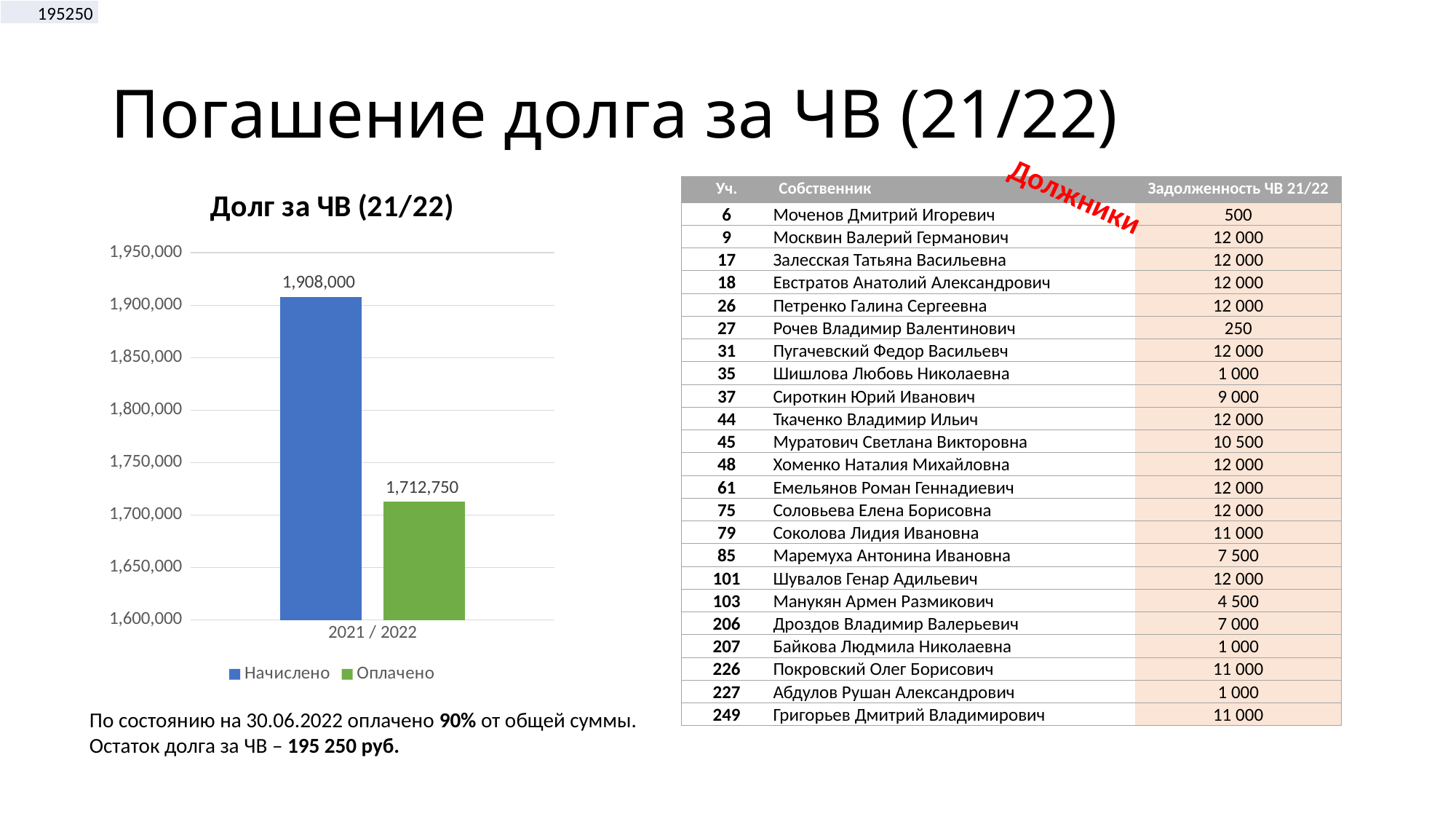
What type of chart is Долг за ЧВ (21/22)? bar chart What colour is the Оплачено bar in the chart Долг за ЧВ (21/22)? green How many categories are shown on the x axis of the chart Долг за ЧВ (21/22)? 1 In the chart Долг за ЧВ (21/22), is the Начислено value larger or smaller than the Оплачено value? larger Which series has the higher value in the chart Долг за ЧВ (21/22)? Начислено Which series has the lower value in the chart Долг за ЧВ (21/22)? Оплачено Is the Оплачено value in the chart Долг за ЧВ (21/22) greater or less than 1,750,000? less What is the value of the Начислено bar in the chart Долг за ЧВ (21/22)? 1,908,000 What is the value of the Оплачено bar in the chart Долг за ЧВ (21/22)? 1,712,750 How many series does the legend of the chart Долг за ЧВ (21/22) list? 2 Is the Начислено value in the chart Долг за ЧВ (21/22) greater or less than 1,850,000? greater What is the difference between the Начислено and Оплачено values in the chart Долг за ЧВ (21/22)? 195,250